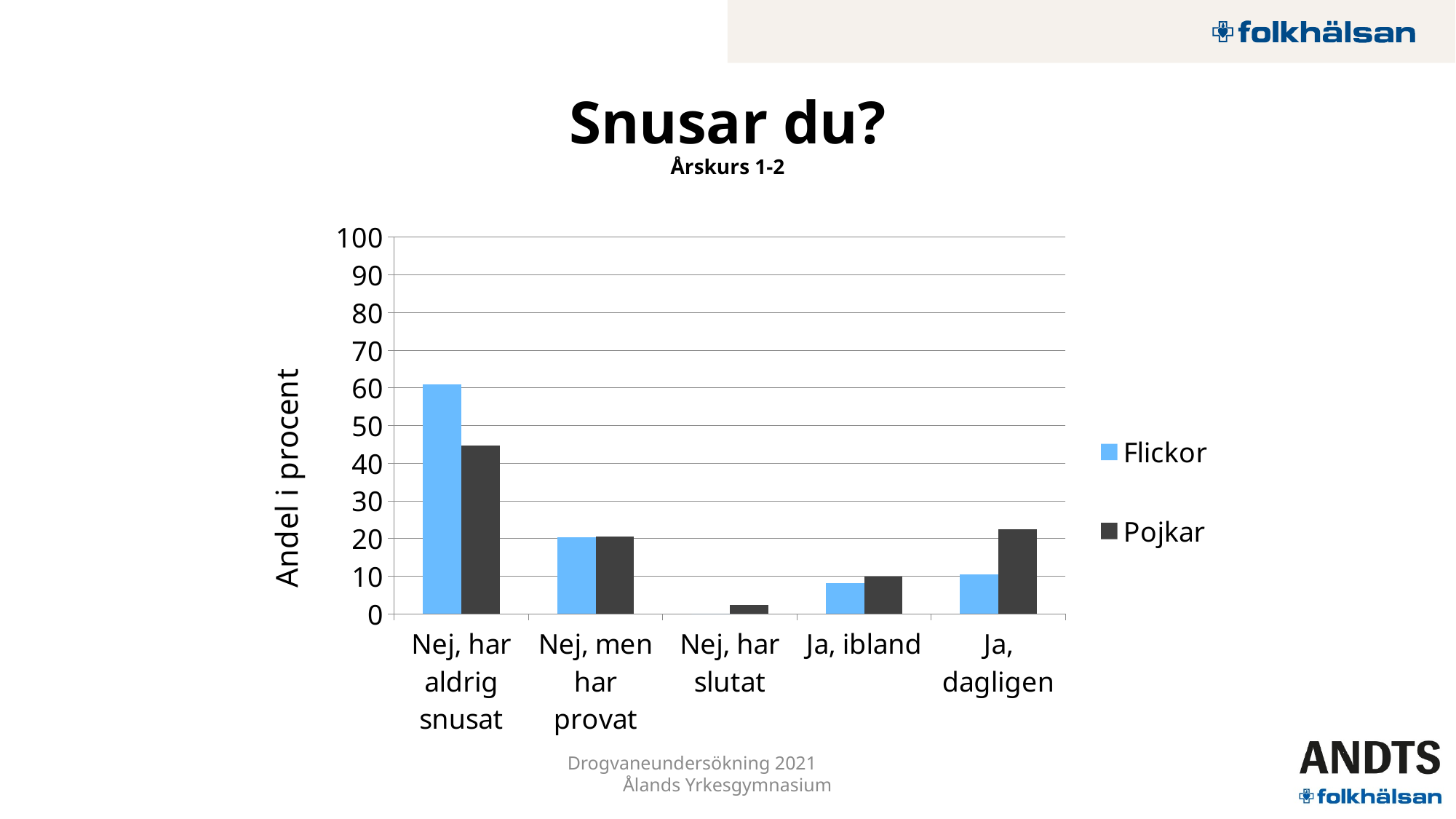
For 'Ja, dagligen', which is larger: Flickor or Pojkar? Pojkar Is the value for Flickor in 'Nej, har aldrig snusat' greater or less than 50? greater For 'Nej, har aldrig snusat', which is larger: Flickor or Pojkar? Flickor Is the value for Pojkar in 'Ja, dagligen' greater or less than 30? less What kind of chart is shown on the slide? bar chart Which category has the highest value for Pojkar? Nej, har aldrig snusat Is the value for Pojkar in 'Nej, har aldrig snusat' greater or less than 50? less Which category has the lowest value for Pojkar? Nej, har slutat How many answer categories are shown on the x axis? 5 How many series does the legend list? 2 What is the title of the y axis? Andel i procent Which category has the highest value for Flickor? Nej, har aldrig snusat